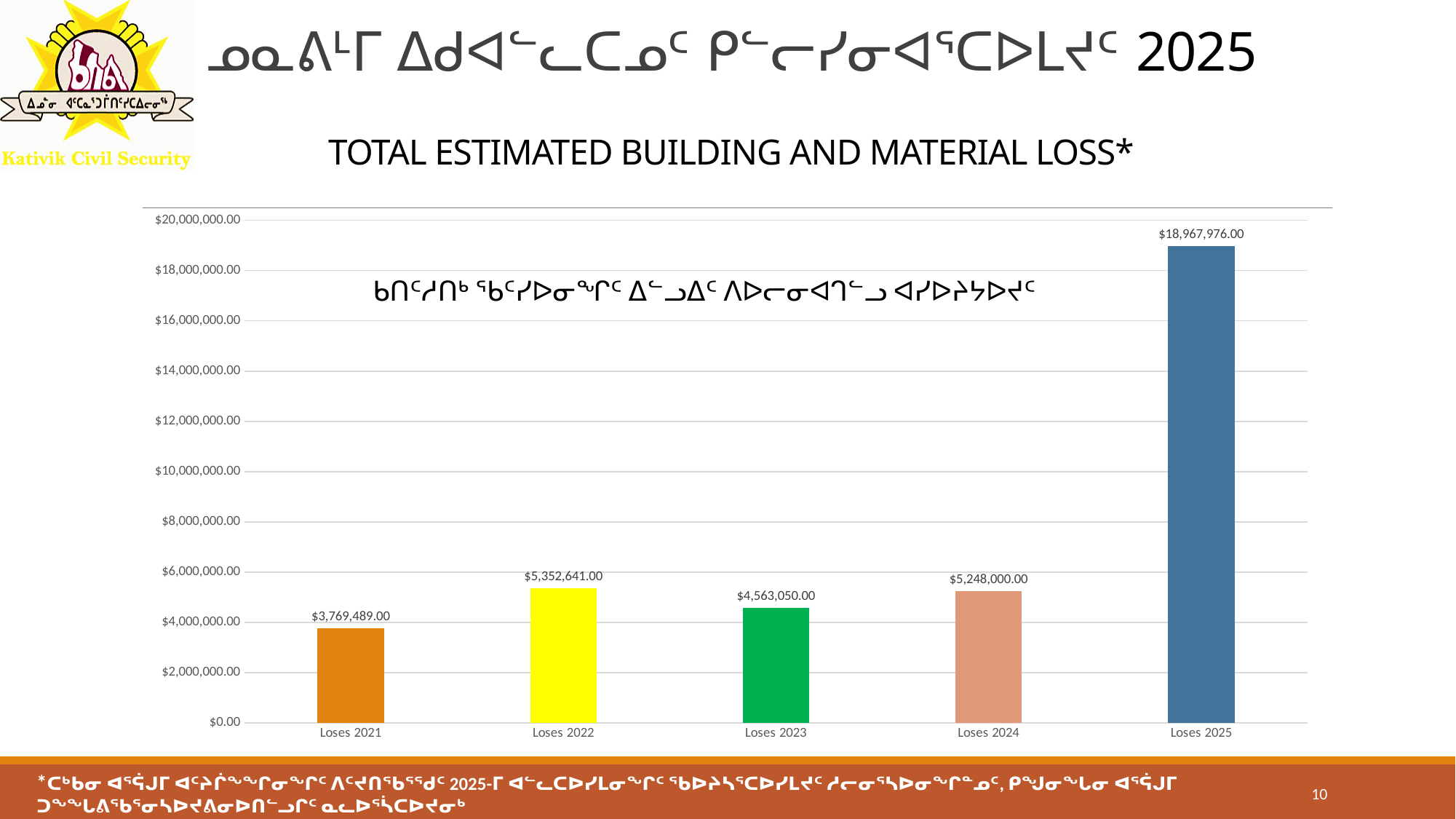
What is the difference between the values for Loses 2025 and Loses 2021? $15,198,487.00 What is the difference between the values for Loses 2022 and Loses 2023? $789,591.00 Is the value for Loses 2025 greater or less than $18,000,000.00? greater What is the value for Loses 2024? $5,248,000.00 Which is larger, the value for Loses 2023 or Loses 2024? Loses 2024 Which category has the lowest value? Loses 2021 What is the value for Loses 2023? $4,563,050.00 How many categories are shown on the x axis? 5 What is the value for Loses 2025? $18,967,976.00 What kind of chart is shown on the slide? bar chart What is the value for Loses 2021? $3,769,489.00 Which category has the highest value? Loses 2025